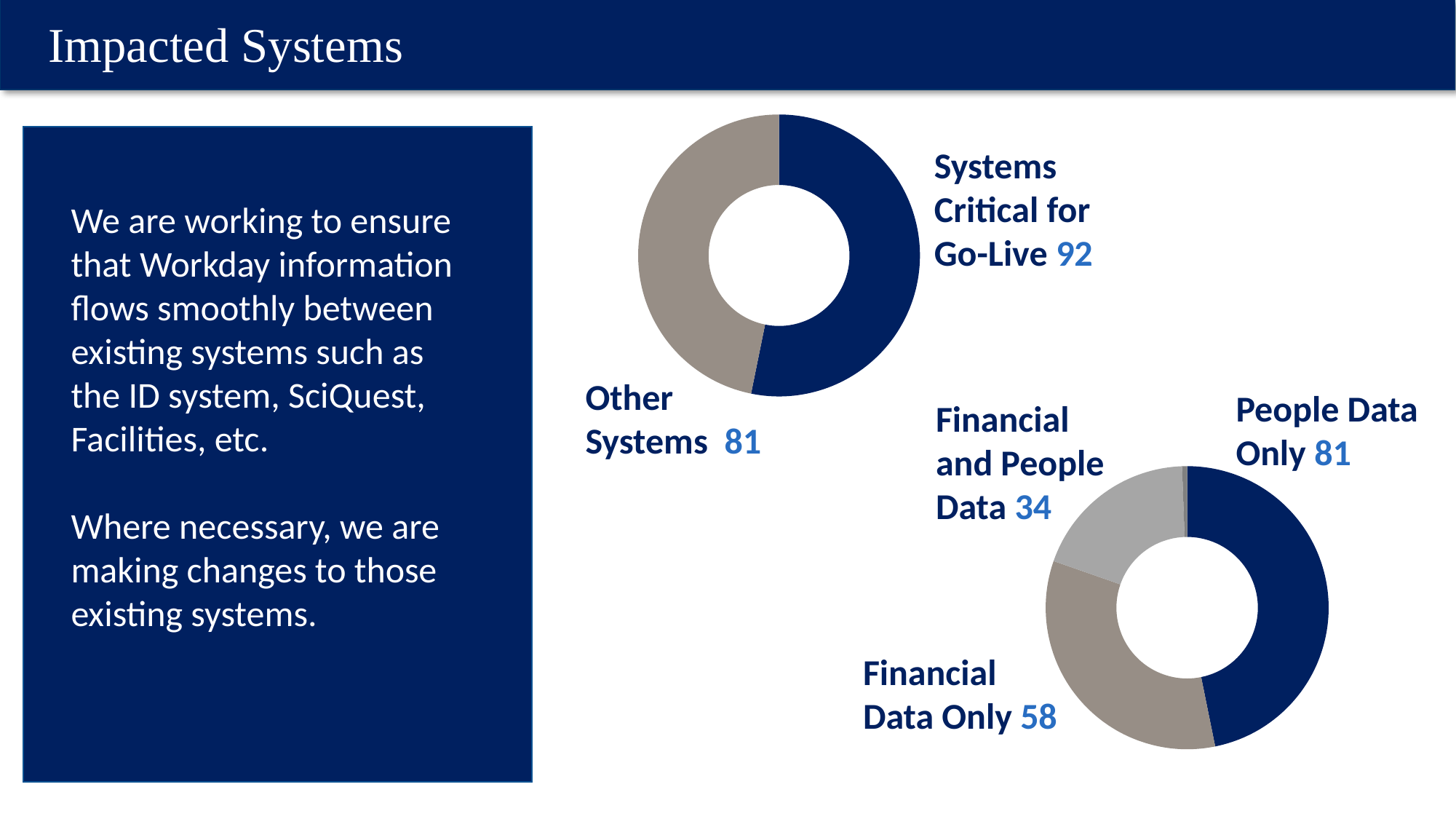
In the lower donut chart, which category has the smallest value? Financial and People Data In the lower donut chart, what is the value for Financial Data Only? 58 In the upper donut chart, what is the difference between Systems Critical for Go-Live and Other Systems? 11 In the lower donut chart, which category has the largest value? People Data Only In the upper donut chart, what is the value for Systems Critical for Go-Live? 92 In the upper donut chart, which is larger: Systems Critical for Go-Live or Other Systems? Systems Critical for Go-Live How many categories does the lower donut chart show? 3 In the lower donut chart, what is the value for People Data Only? 81 In the lower donut chart, what is the difference between Financial Data Only and Financial and People Data? 24 In the upper donut chart, what is the value for Other Systems? 81 In the lower donut chart, what is the value for Financial and People Data? 34 What type of chart is used on this slide? Donut (pie) chart